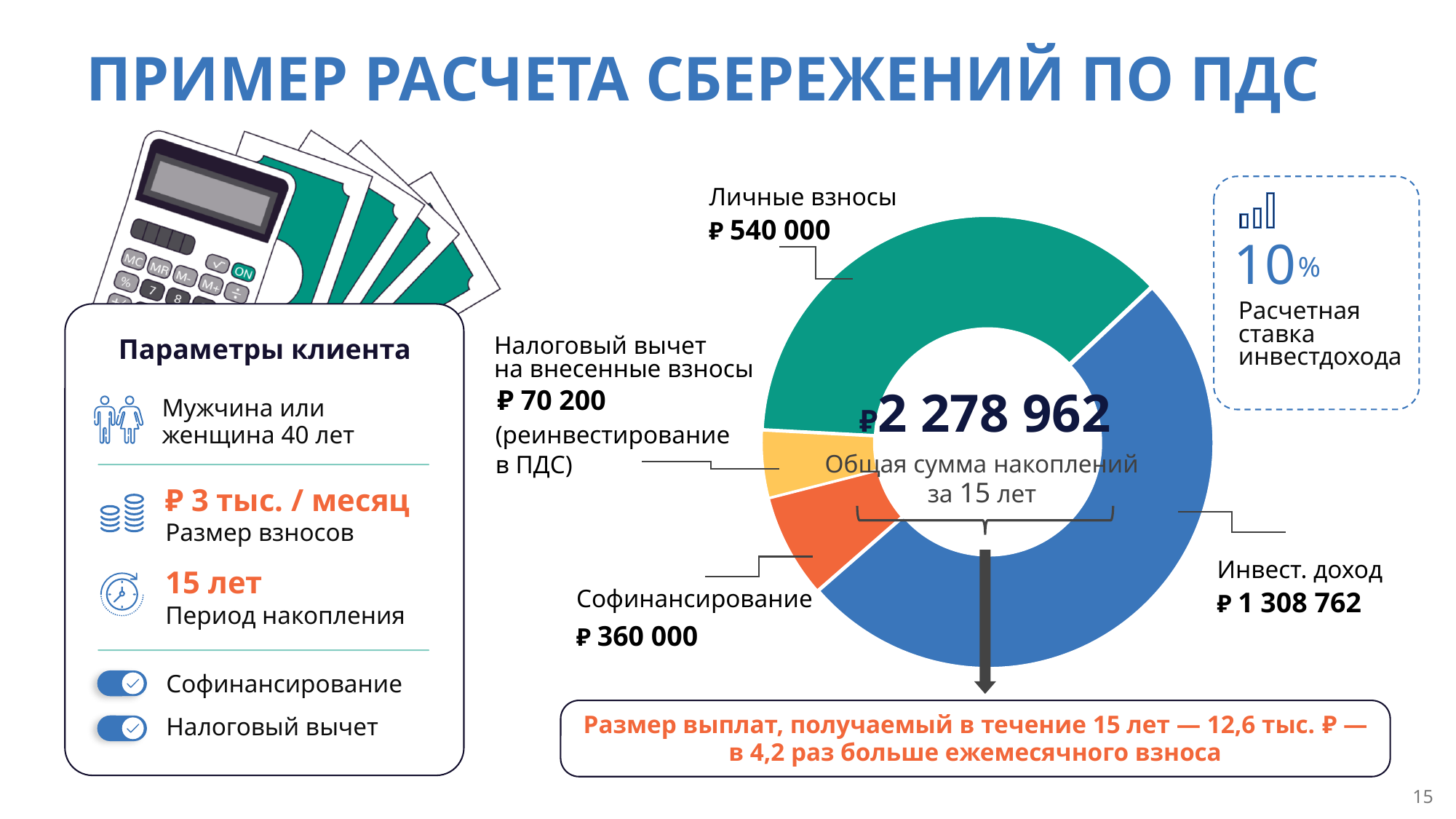
What is the value for Софинансирование in the chart? ₽ 360 000 Which segment of the chart has the largest value? Инвест. доход What type of chart is shown on the slide? Pie (donut) chart What is the difference between Инвест. доход and Личные взносы? ₽ 768 762 What is the value for Личные взносы in the chart? ₽ 540 000 What is the value for Налоговый вычет на внесенные взносы in the chart? ₽ 70 200 What is the total sum of savings shown in the centre of the chart (Общая сумма накоплений за 15 лет)? ₽2 278 962 What colour is the Инвест. доход segment of the chart? Blue How many segments does the donut chart have? 4 What is the value for Инвест. доход in the chart? ₽ 1 308 762 Which segment of the chart has the smallest value? Налоговый вычет на внесенные взносы Which is larger: Личные взносы or Софинансирование? Личные взносы